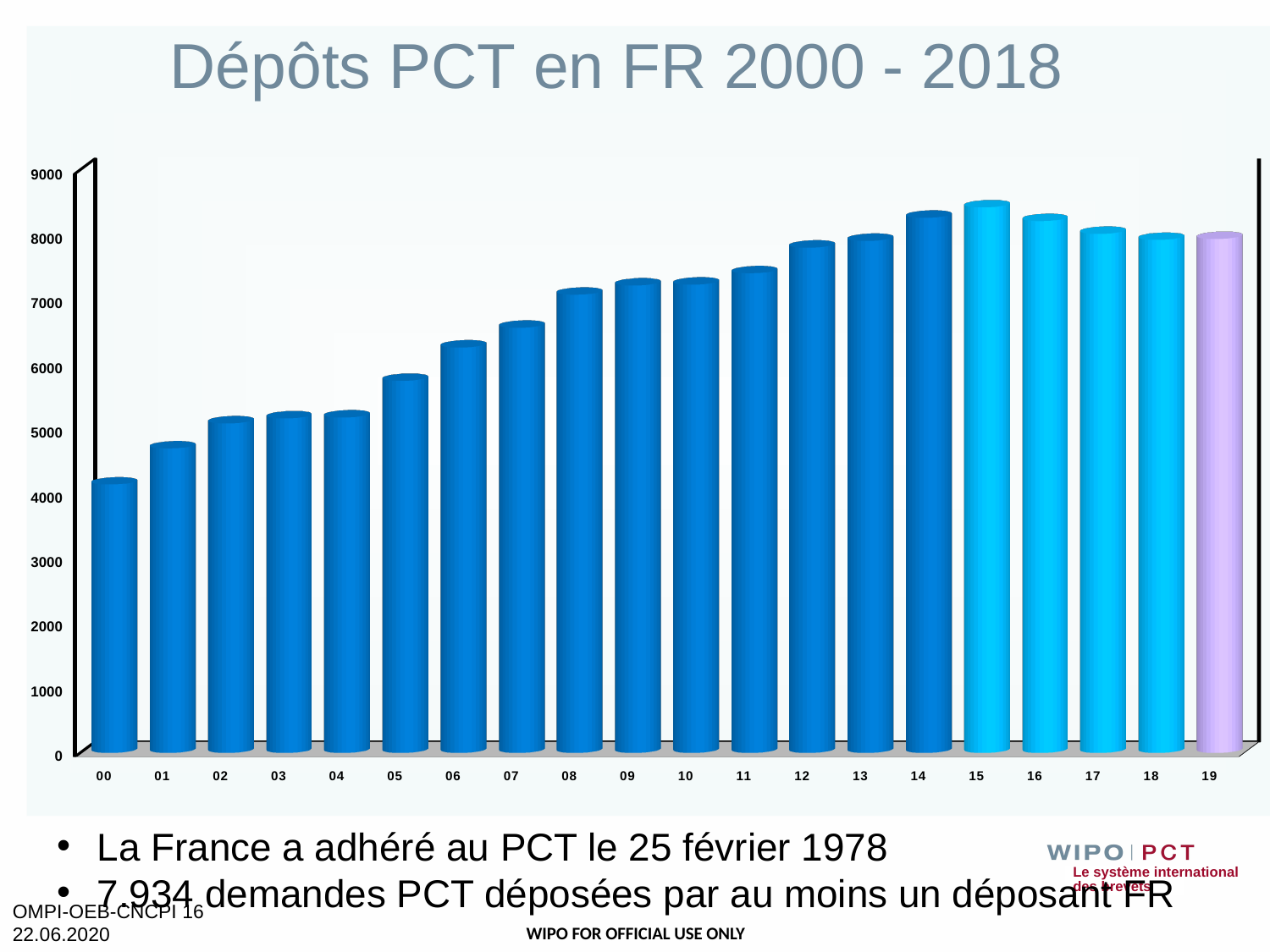
Is the value for 15 greater or less than 8000? greater What kind of chart is shown on the slide? bar chart Which year has the lowest bar in the chart? 00 How many bars (years) are plotted in the chart? 20 Is the value for 00 greater or less than 5000? less Which year's bar is shown in a different (purple) colour from the blue bars? 19 What is the title of the chart? Dépôts PCT en FR 2000 - 2018 Is the value for 05 greater or less than 5000? greater Do the values generally rise or fall from 00 to 15? rise Which is larger, the value for 00 or the value for 14? 14 Which year has the highest bar in the chart? 15